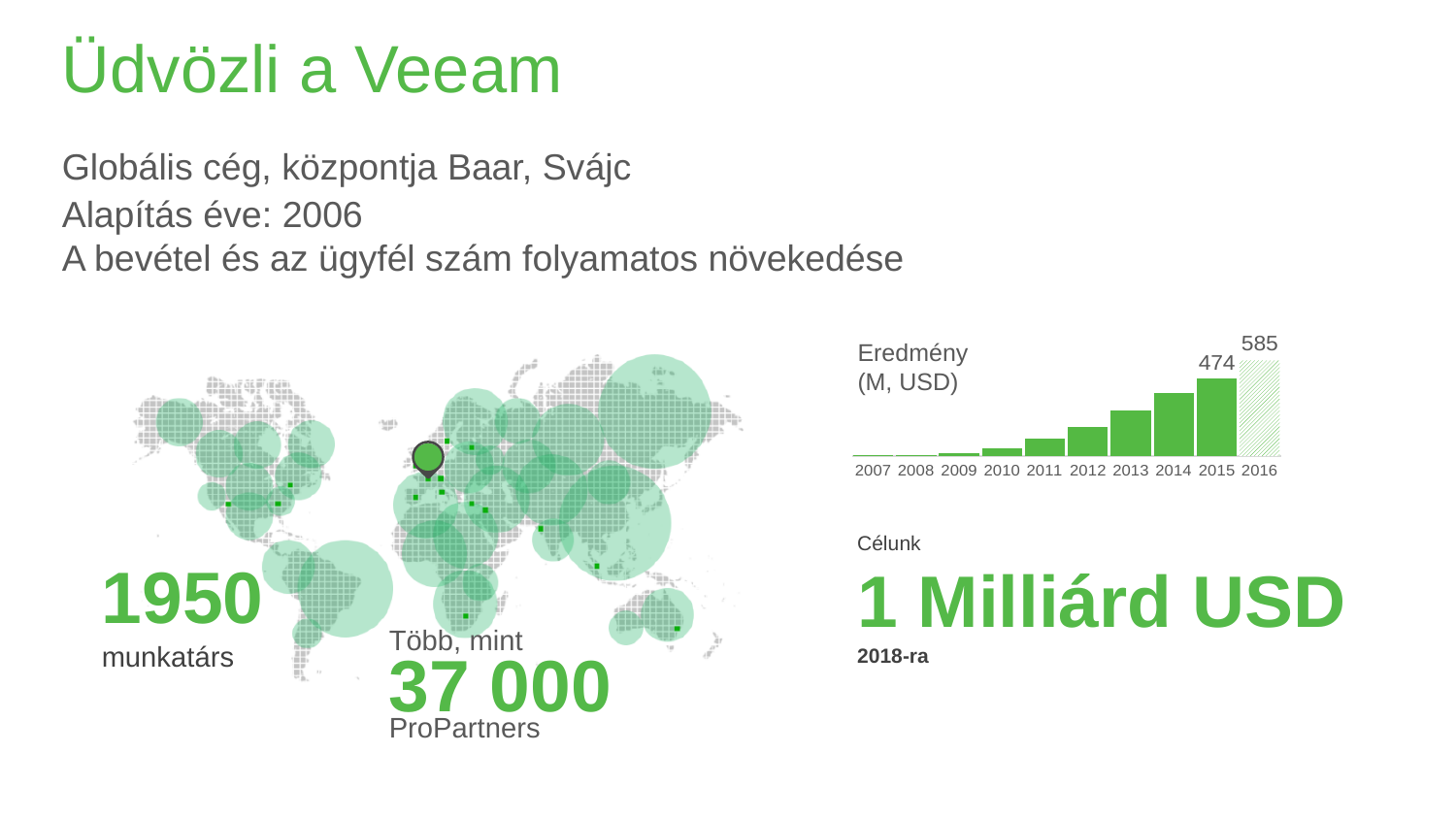
What is the difference between the 2016 and 2015 values in the Eredmény (M, USD) chart? 111 What is the first year shown on the x axis of the Eredmény (M, USD) chart? 2007 What kind of chart is the Eredmény (M, USD) chart? bar chart In the Eredmény (M, USD) chart, which is larger: the value for 2012 or the value for 2014? 2014 How many years are shown on the x axis of the Eredmény (M, USD) chart? 10 Which year has the highest value in the Eredmény (M, USD) chart? 2016 Do the values in the Eredmény (M, USD) chart rise or fall from 2007 to 2016? rise What is the value for 2015 in the Eredmény (M, USD) chart? 474 What is the value for 2016 in the Eredmény (M, USD) chart? 585 In the Eredmény (M, USD) chart, which is larger: the value for 2015 or the value for 2016? 2016 What unit is given in the title of the bar chart on the right of the slide? M, USD